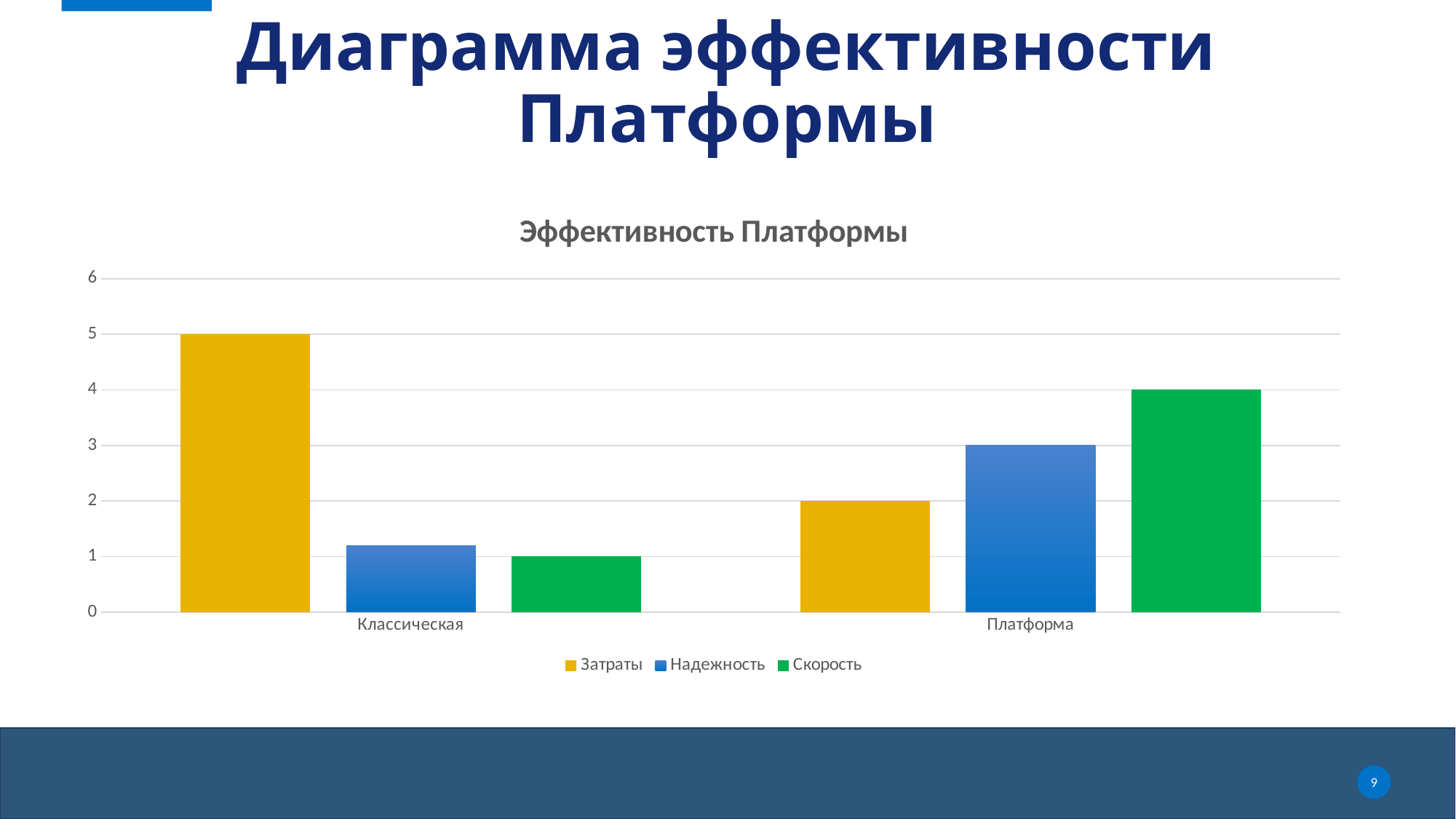
What is the value of Затраты for Классическая? 5 What is the value of Скорость for Платформа? 4 Which category has the larger value for Скорость, Классическая or Платформа? Платформа Which series has the highest value for Классическая? Затраты How many series does the legend of the chart list? 3 Is the value of Надежность for Классическая greater or less than 2? less What is the difference between Затраты for Классическая and Затраты for Платформа? 3 What is the value of Надежность for Платформа? 3 What kind of chart is shown on the slide? bar chart What is the value of Затраты for Платформа? 2 Which series has the lowest value for Платформа? Затраты How many categories are shown on the x axis of the chart? 2